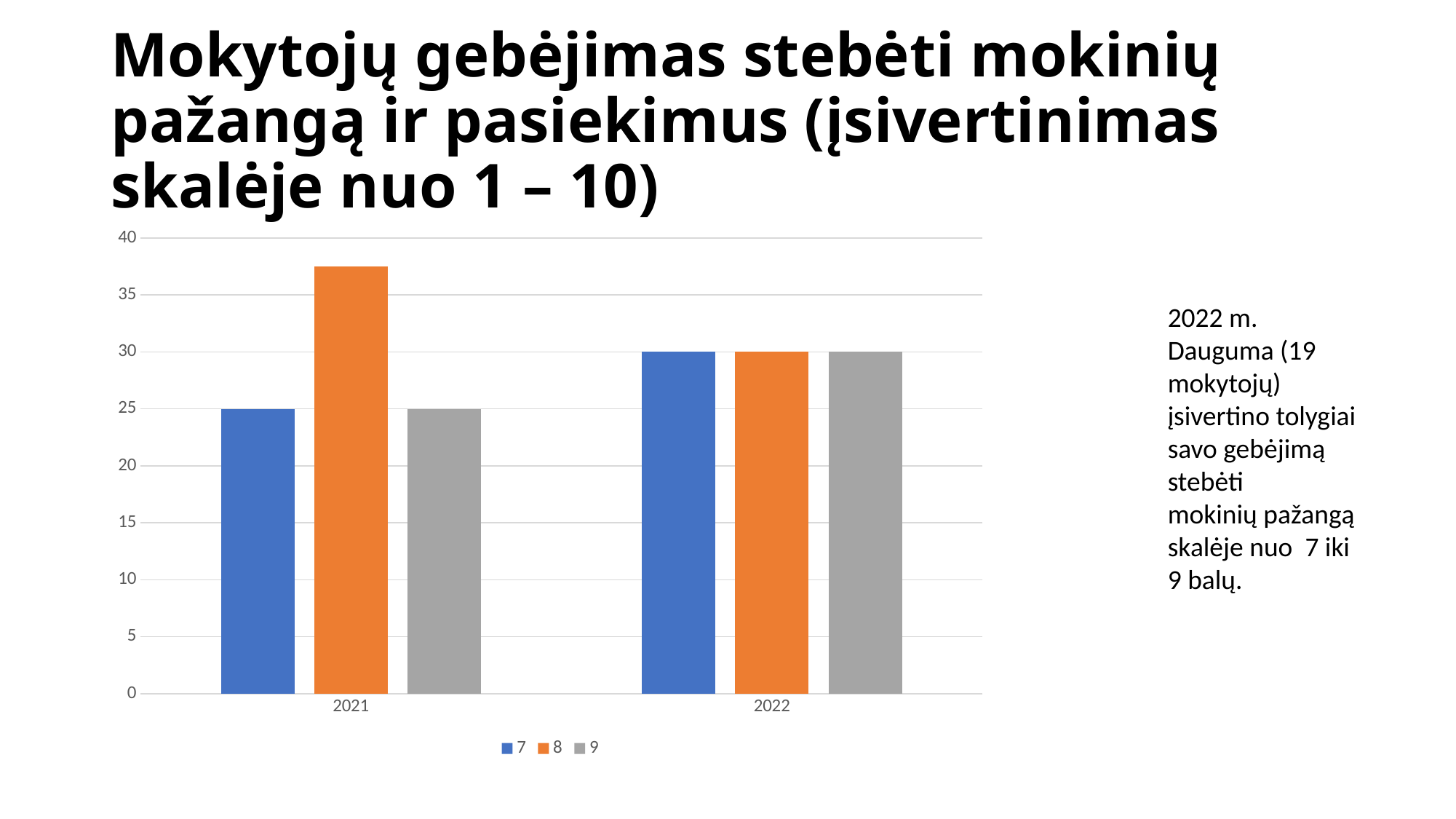
What are the entries listed in the chart's legend? 7, 8, 9 What is the value for series 7 in 2022? 30 What is the value for series 9 in 2022? 30 By how much does the value for series 9 change from 2021 to 2022? 5 How many series does the chart's legend list? 3 What is the value for series 7 in 2021? 25 Which is larger for series 7: the value in 2021 or the value in 2022? 2022 Which series has the highest value in 2021? 8 How many categories are shown on the x axis of the chart? 2 What kind of chart is shown on the slide? bar chart Is the value for series 8 in 2021 greater or less than 35? greater What is the value for series 9 in 2021? 25